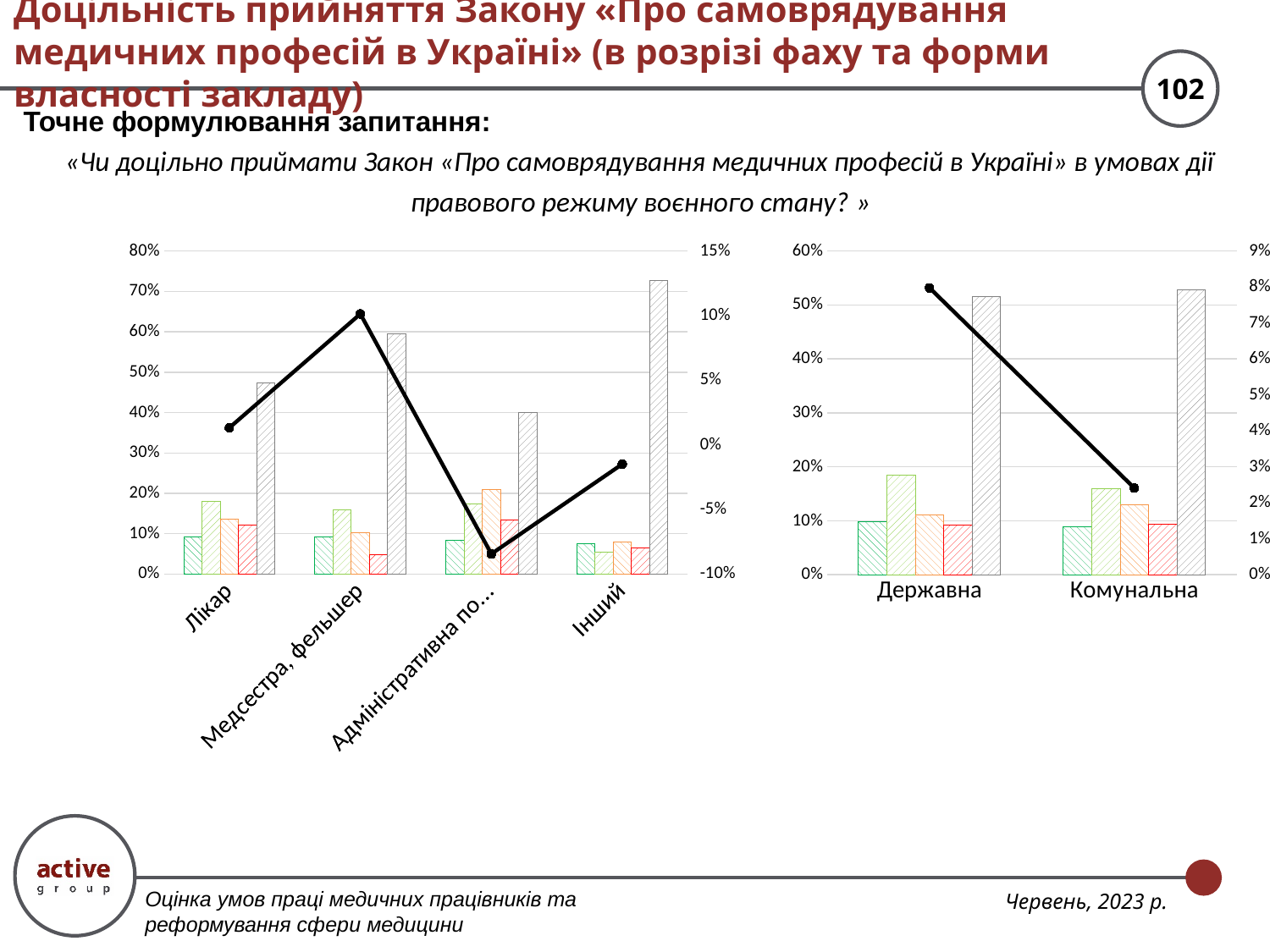
What kind of chart is the left chart? Combination bar and line chart In the left chart, at which category does the black line reach its highest point? Медсестра, фельшер In the right chart, is the black line value for Державна greater or less than 7% on the right axis? greater In the left chart, is the grey hatched bar for Лікар greater or less than 50%? less In the left chart, at which category does the black line reach its lowest point? Адміністративна по... In the left chart, is the black line value for Адміністративна по... greater or less than -5% on the right axis? less In the right chart, does the black line rise or fall from Державна to Комунальна? fall In the left chart, how many categories are shown on the x axis? 4 In the left chart, which category has the tallest grey hatched bar? Інший In the right chart, how many categories are shown on the x axis? 2